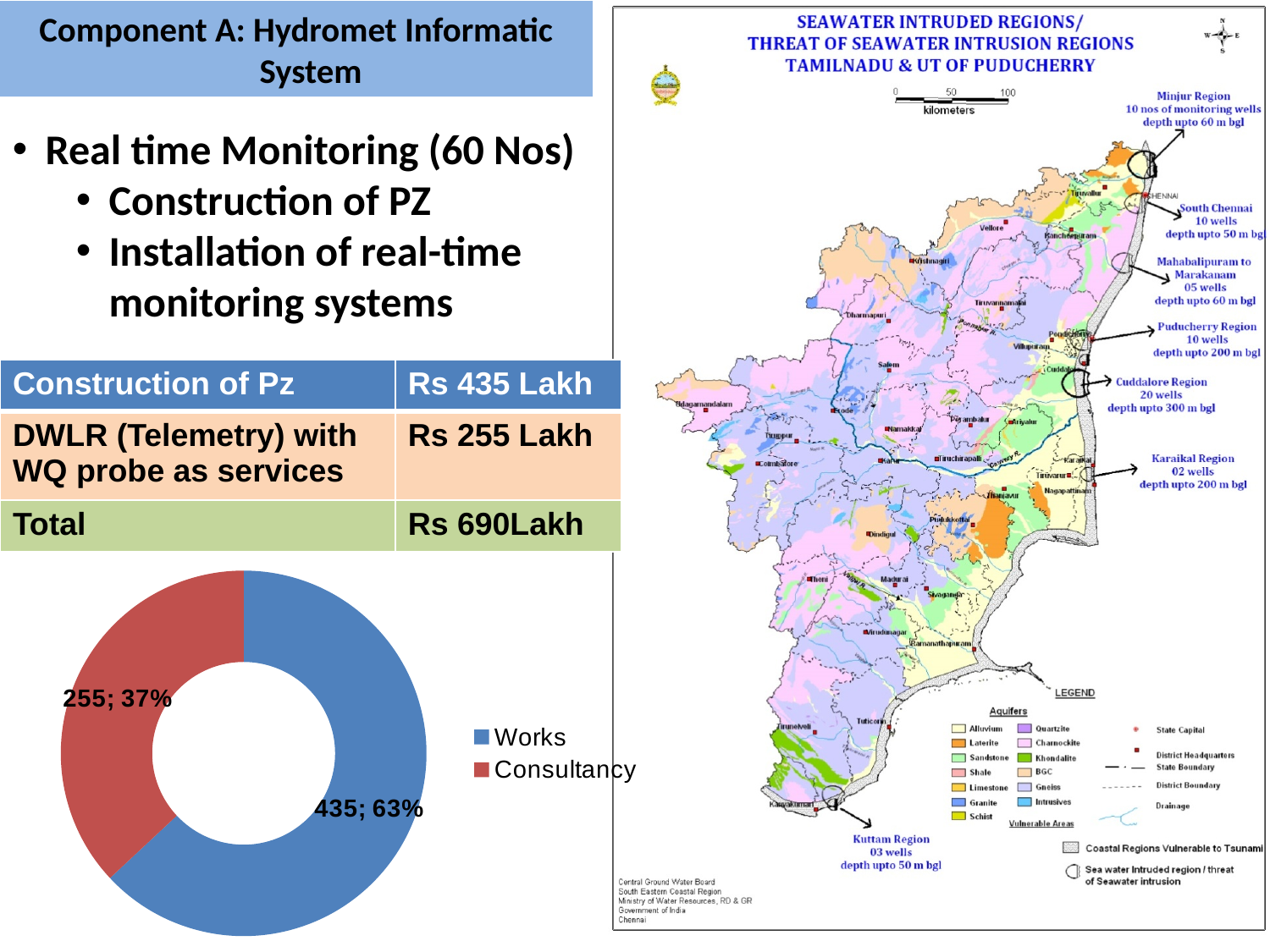
In the doughnut chart, what share does Consultancy have? 37% In the doughnut chart, what is the difference between the Works value and the Consultancy value? 180 In the doughnut chart, what colour is the Consultancy slice? red In the doughnut chart, what is the value for Consultancy? 255 In the doughnut chart, which is larger, Works or Consultancy? Works What kind of chart is shown at the bottom left of the slide? doughnut chart In the doughnut chart, which category has the largest slice? Works How many categories does the doughnut chart show? 2 In the doughnut chart, what is the value for Works? 435 What is the total of the two values in the doughnut chart? 690 In the doughnut chart, what share does Works have? 63% In the doughnut chart, which category has the smallest slice? Consultancy